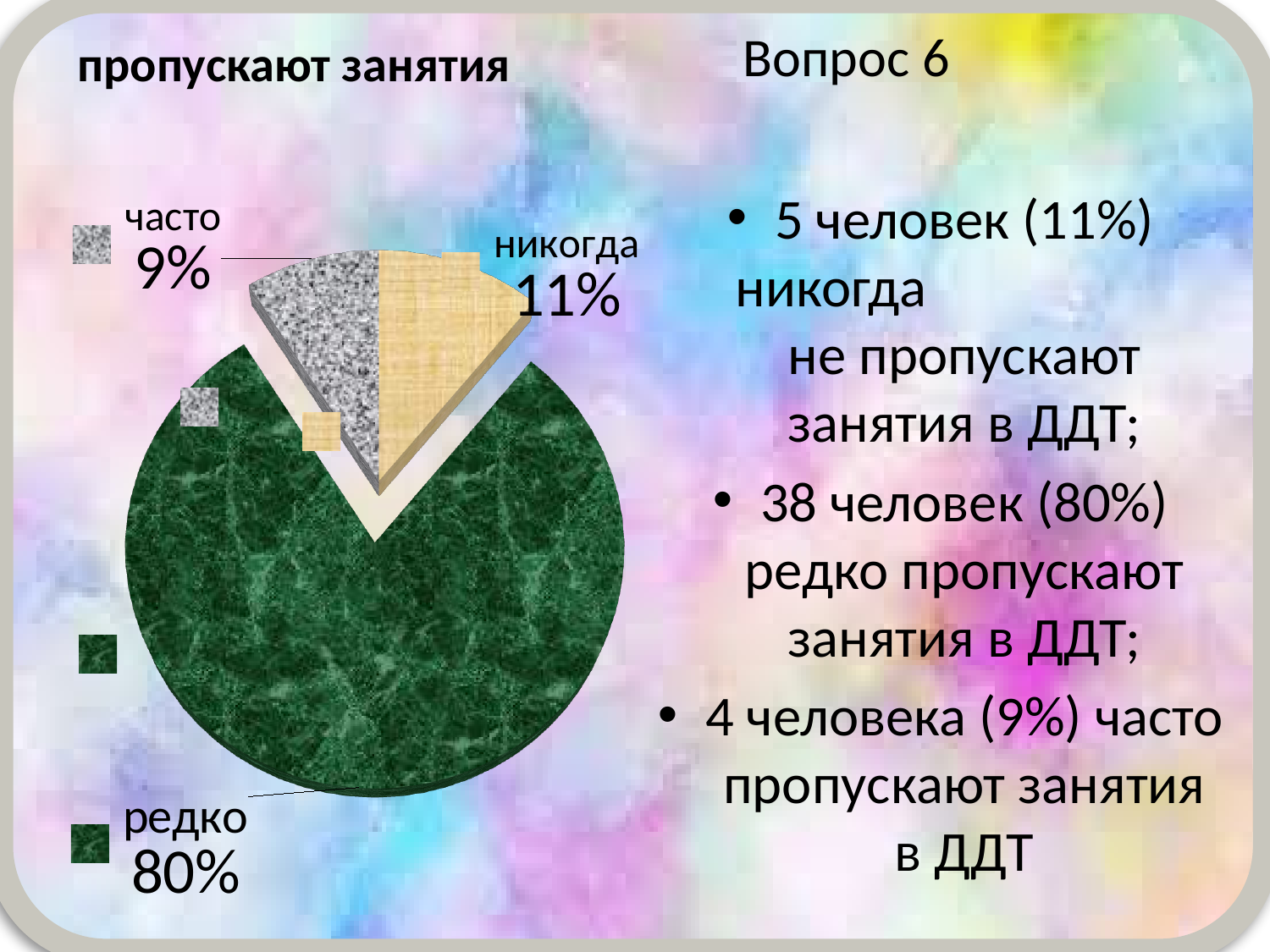
Which category has the smallest slice of the pie? часто What is the difference in percentage points between the "редко" and "никогда" slices? 69 Which slice is larger, "никогда" or "часто"? никогда What is the difference in percentage points between the "никогда" and "часто" slices? 2 What is the value shown for the "часто" slice? 9% How many slices does the pie chart have? 3 What kind of chart is shown on the slide? pie chart What share of the pie does the "редко" slice represent? 80% What is the value shown for the "никогда" slice? 11% What is the title of the pie chart? пропускают занятия What colour is the "редко" slice of the pie? green Which category has the largest slice of the pie? редко